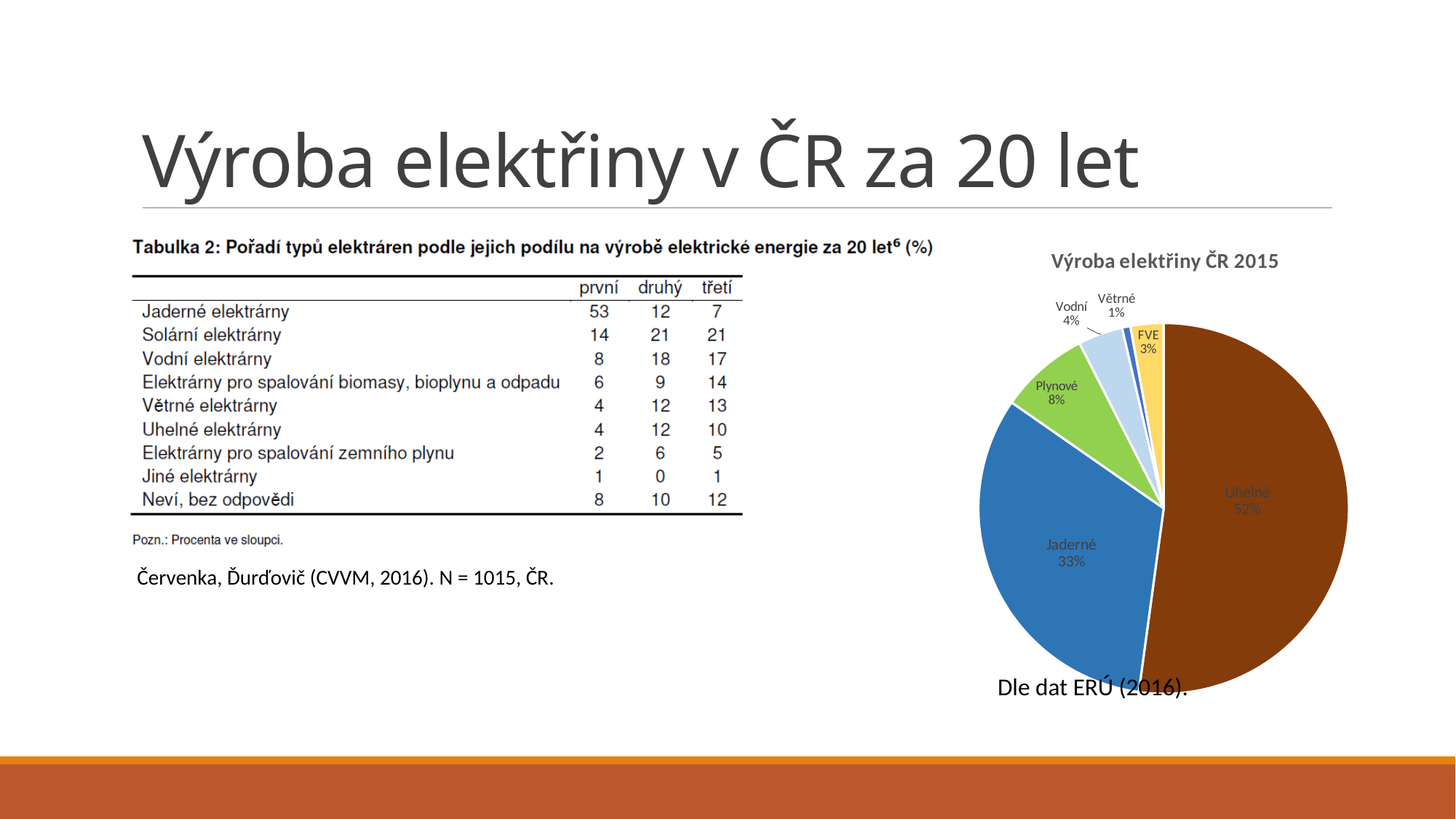
Which slice of the pie chart is the smallest? Větrné How many slices does the pie chart have? 6 What is the difference between the Uhelné and Jaderné shares in the pie chart? 19% What is the value shown for Plynové in the pie chart? 8% What kind of chart is shown on the slide? pie chart What share of the pie does Uhelné have? 52% Which slice of the pie chart is the largest? Uhelné What is the title of the pie chart? Výroba elektřiny ČR 2015 What is the value shown for FVE in the pie chart? 3% What share of the pie does Jaderné have? 33% Which is larger in the pie chart, Plynové or Vodní? Plynové What is the value shown for Vodní in the pie chart? 4%